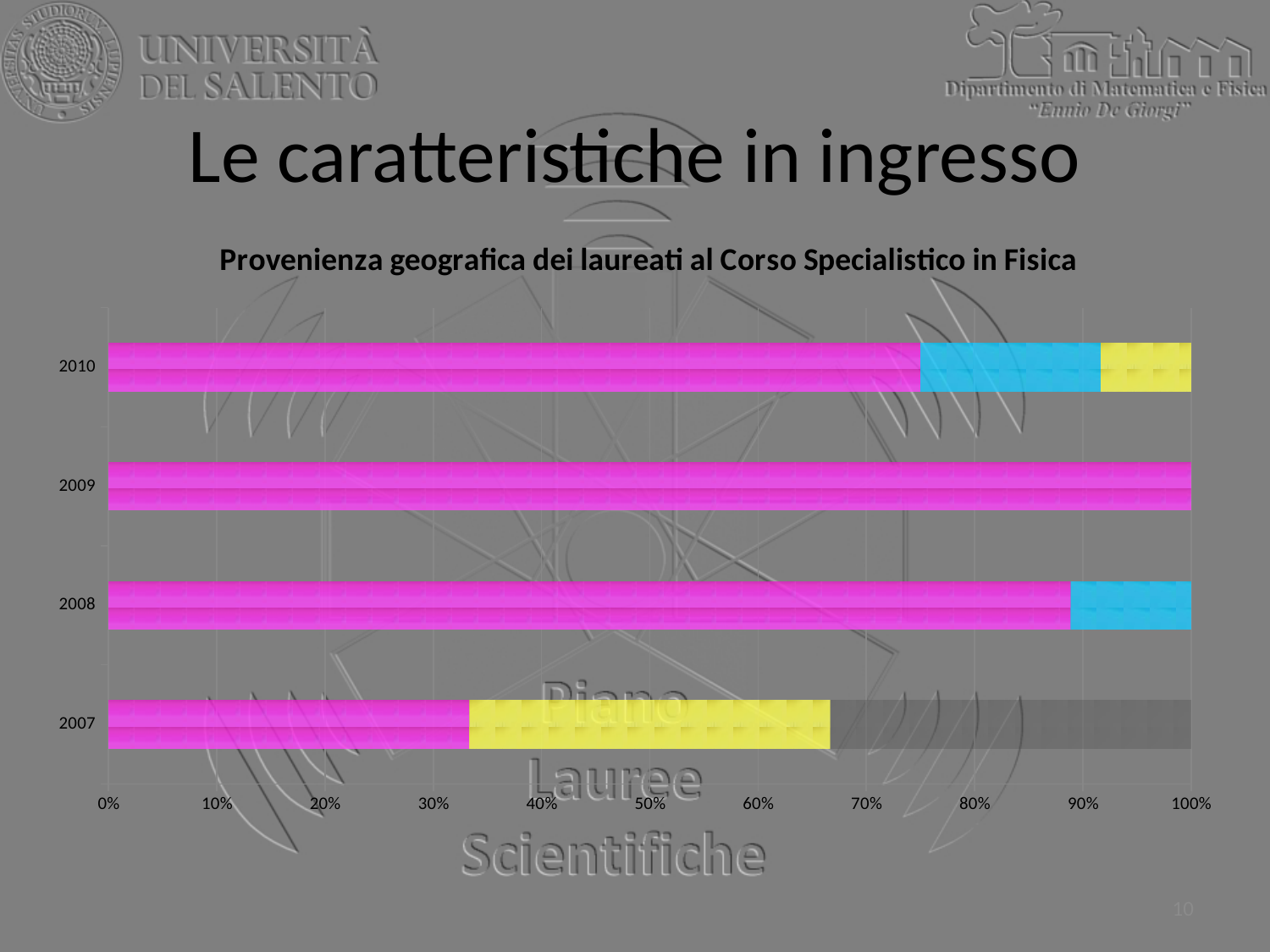
What kind of chart is shown on the slide? stacked bar chart What is the highest value shown on the horizontal axis? 100% Which year has the largest magenta segment? 2009 Which year's bar contains a grey segment? 2007 How many years (categories) are shown on the chart? 4 Which year has the smallest magenta segment? 2007 Which year has a larger magenta segment, 2008 or 2010? 2008 Is the magenta segment for 2007 greater or less than 30%? greater Is the magenta segment for 2010 greater or less than 70%? greater Is the magenta segment for 2008 greater or less than 80%? greater What is the title of the chart? Provenienza geografica dei laureati al Corso Specialistico in Fisica